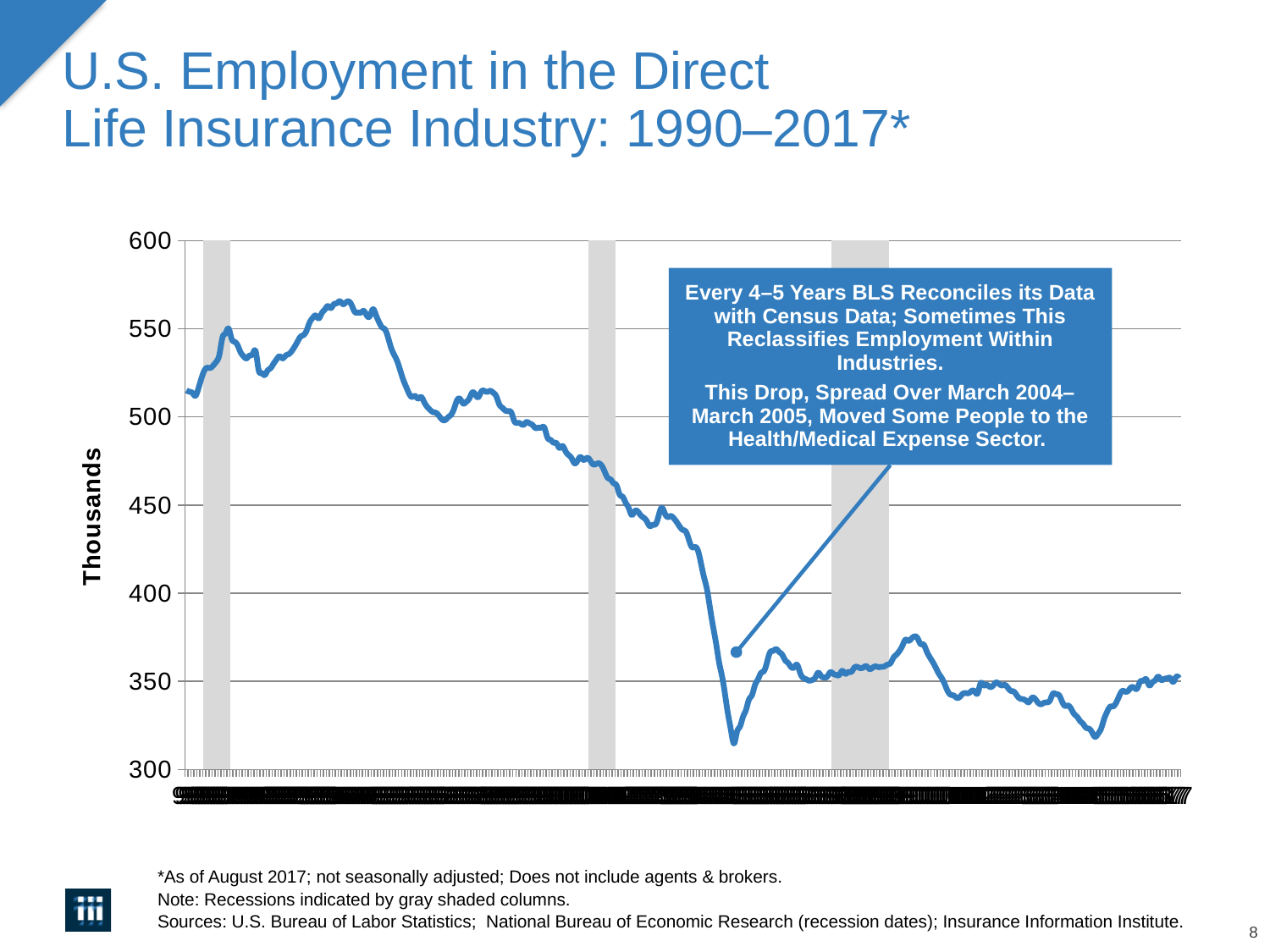
Is the value at the start of the line higher or lower than the value at the end of the line? Higher According to the note on the slide, what do the gray shaded columns on the chart indicate? Recessions What kind of chart is shown on the slide? Line chart What is the label on the vertical axis of the chart? Thousands Is the value at the left end of the line (the earliest point) greater or less than 500? greater Is the highest point on the line greater or less than 600? less Is the lowest point on the line greater or less than 300? greater Overall, do the values rise or fall from the left of the chart to the right? Fall